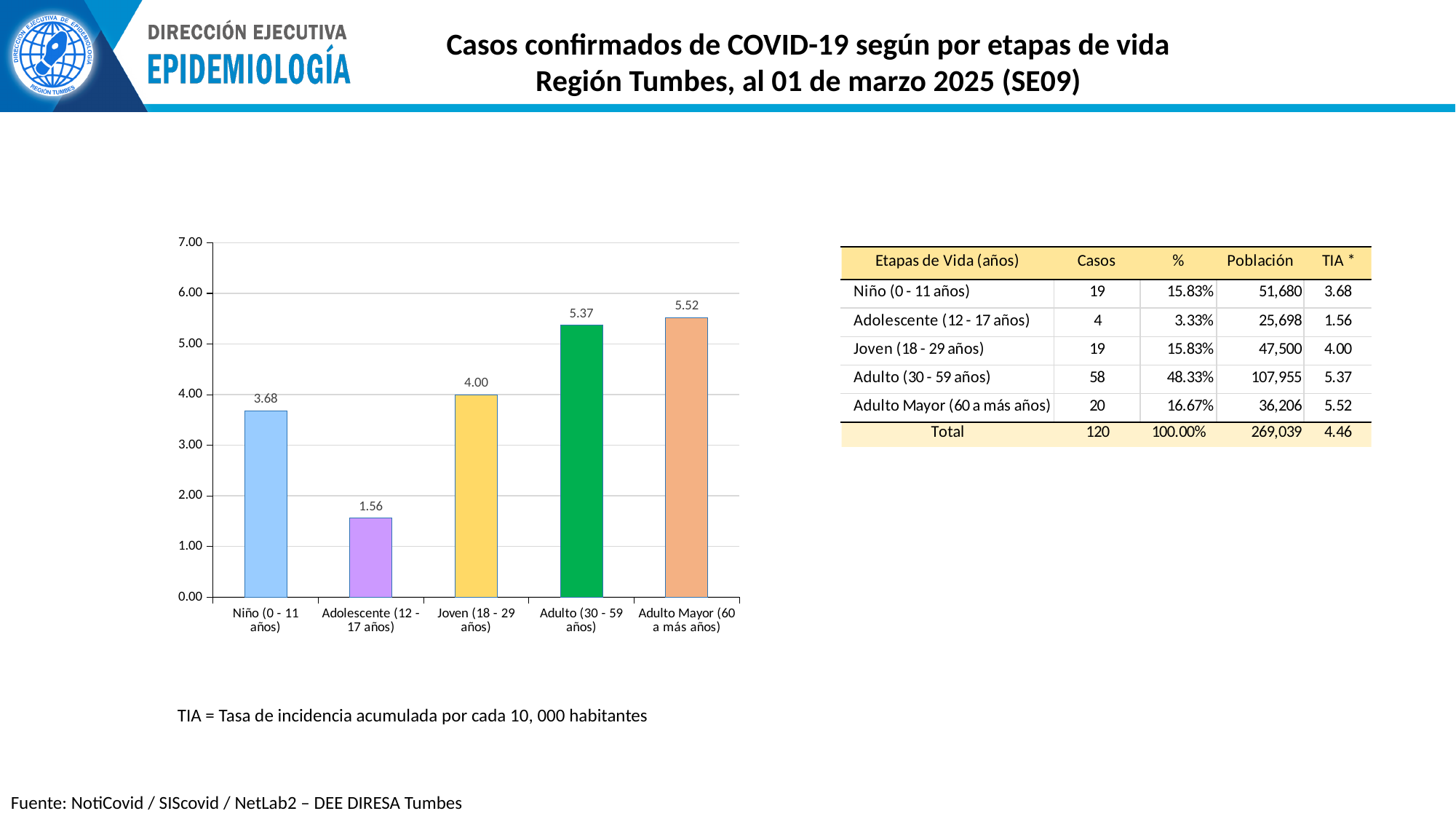
Which category has the lowest value in the bar chart? Adolescente (12 - 17 años) What colour is the bar for Adulto (30 - 59 años) in the bar chart? green What is the value shown for Adolescente (12 - 17 años) in the bar chart? 1.56 Which category has the highest value in the bar chart? Adulto Mayor (60 a más años) What is the value shown for Adulto (30 - 59 años) in the bar chart? 5.37 What is the value shown for Joven (18 - 29 años) in the bar chart? 4.00 Is the value for Adulto (30 - 59 años) in the bar chart greater or less than 5.00? greater What kind of chart is shown on the slide? bar chart How many categories are shown in the bar chart? 5 Which is larger in the bar chart: the value for Niño (0 - 11 años) or the value for Joven (18 - 29 años)? Joven (18 - 29 años) What is the difference between the values for Adulto Mayor (60 a más años) and Adolescente (12 - 17 años) in the bar chart? 3.96 What is the value shown for Niño (0 - 11 años) in the bar chart? 3.68